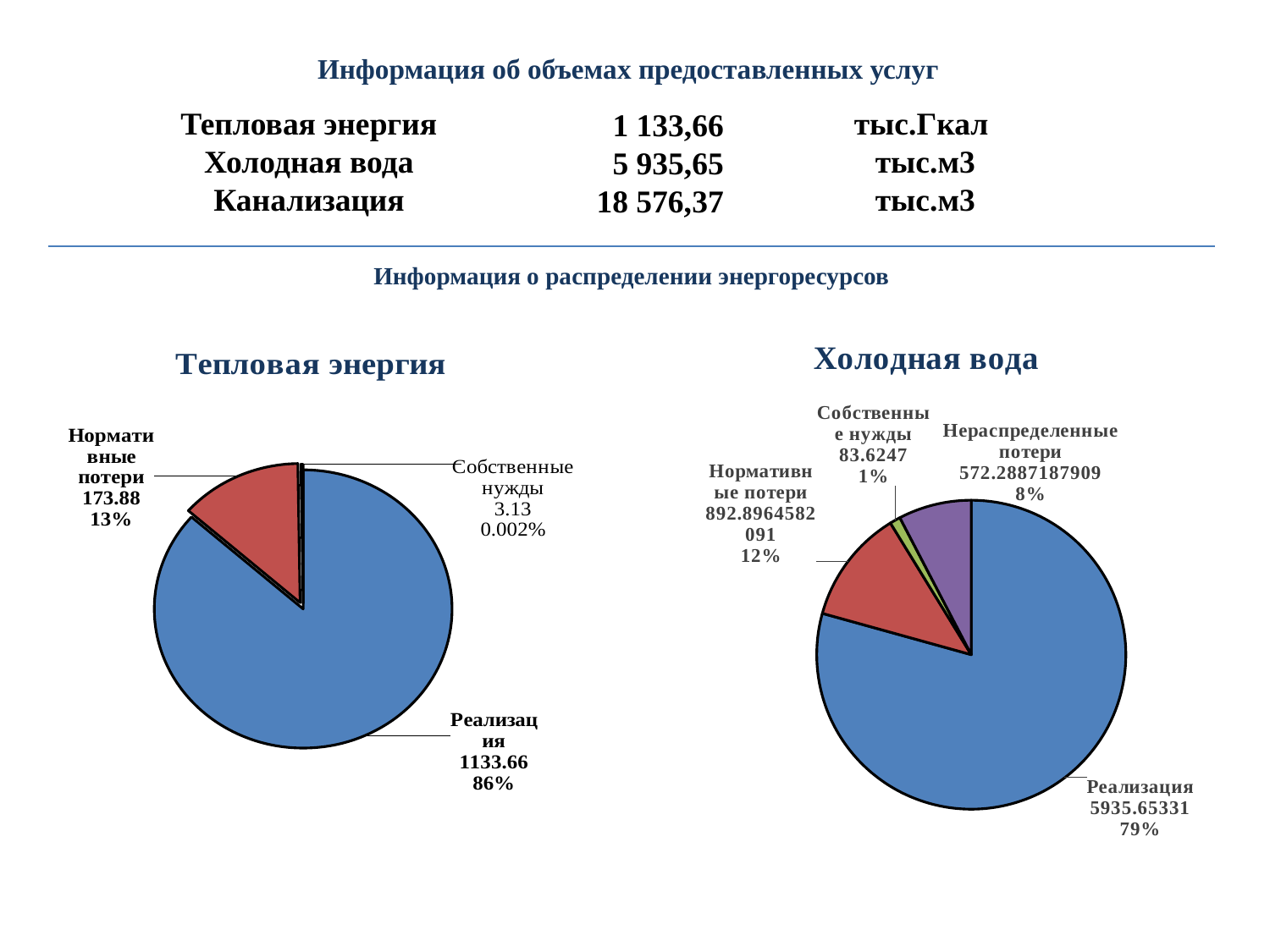
How many slices does the "Тепловая энергия" pie chart have? 3 In the "Холодная вода" chart, what share of the pie is Нераспределенные потери? 8% What type of chart is the "Холодная вода" chart? Pie chart In the "Тепловая энергия" chart, what share of the pie is Нормативные потери? 13% In the "Тепловая энергия" chart, which category has the smallest slice? Собственные нужды In the "Холодная вода" chart, what is the value for Реализация? 5935.65331 In the "Тепловая энергия" chart, what is the value for Собственные нужды? 3.13 How many slices does the "Холодная вода" pie chart have? 4 In the "Холодная вода" chart, what is the value for Собственные нужды? 83.6247 In the "Холодная вода" chart, which is larger: Нормативные потери or Нераспределенные потери? Нормативные потери In the "Тепловая энергия" chart, what is the value for Реализация? 1133.66 In the "Тепловая энергия" chart, which category has the largest slice? Реализация